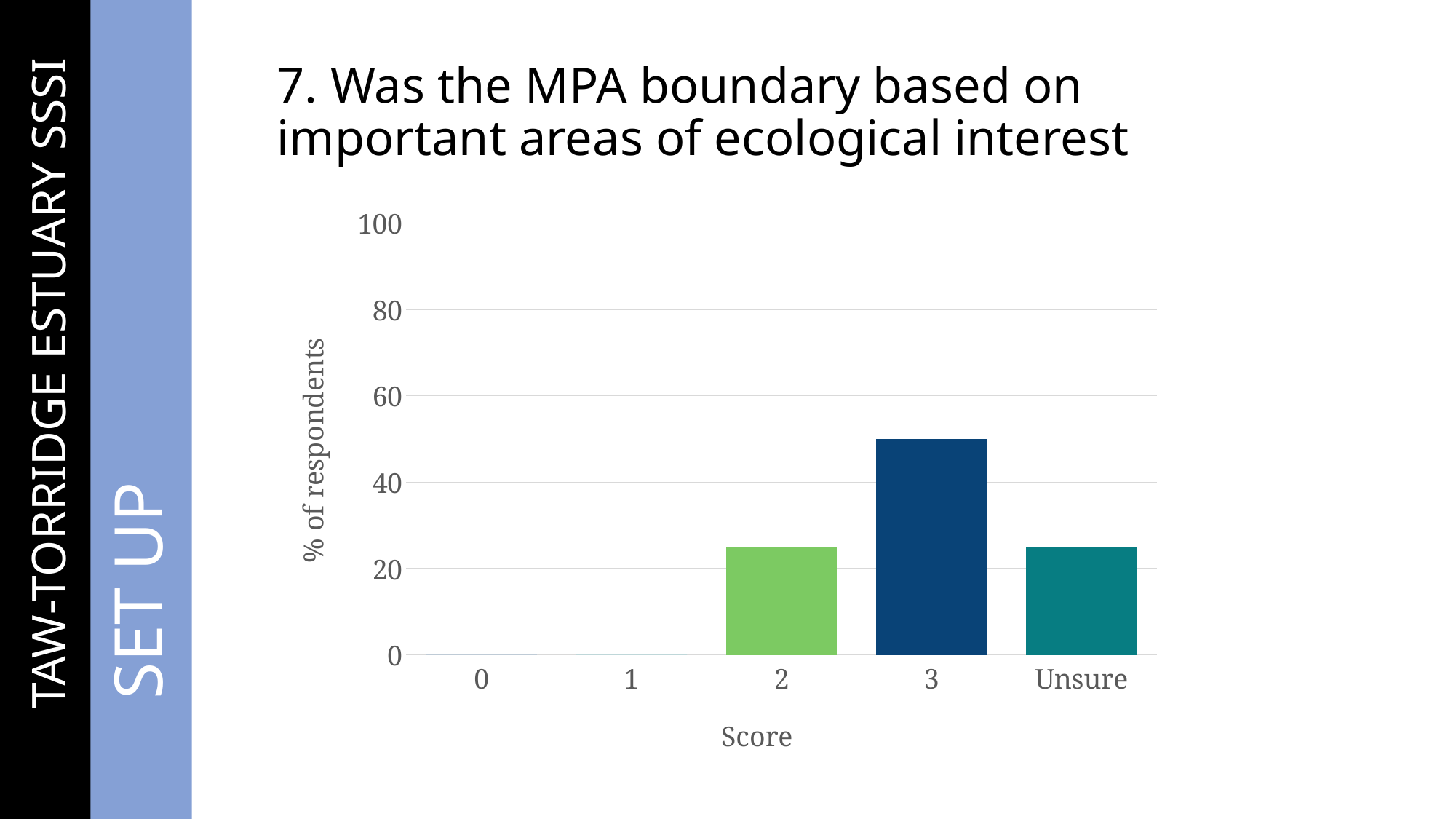
What kind of chart is shown on the slide? bar chart What is the label of the horizontal axis? Score What is the value for score 1? 0 What is the value for score 0? 0 Is the value for Unsure greater or less than 20? greater Which is larger, the value for score 3 or the value for score 2? score 3 Which score category has the highest percentage of respondents? 3 What is the label of the vertical axis? % of respondents How many score categories are shown on the x axis? 5 Is the value for score 3 greater or less than 60? less Is the value for score 2 greater or less than 40? less